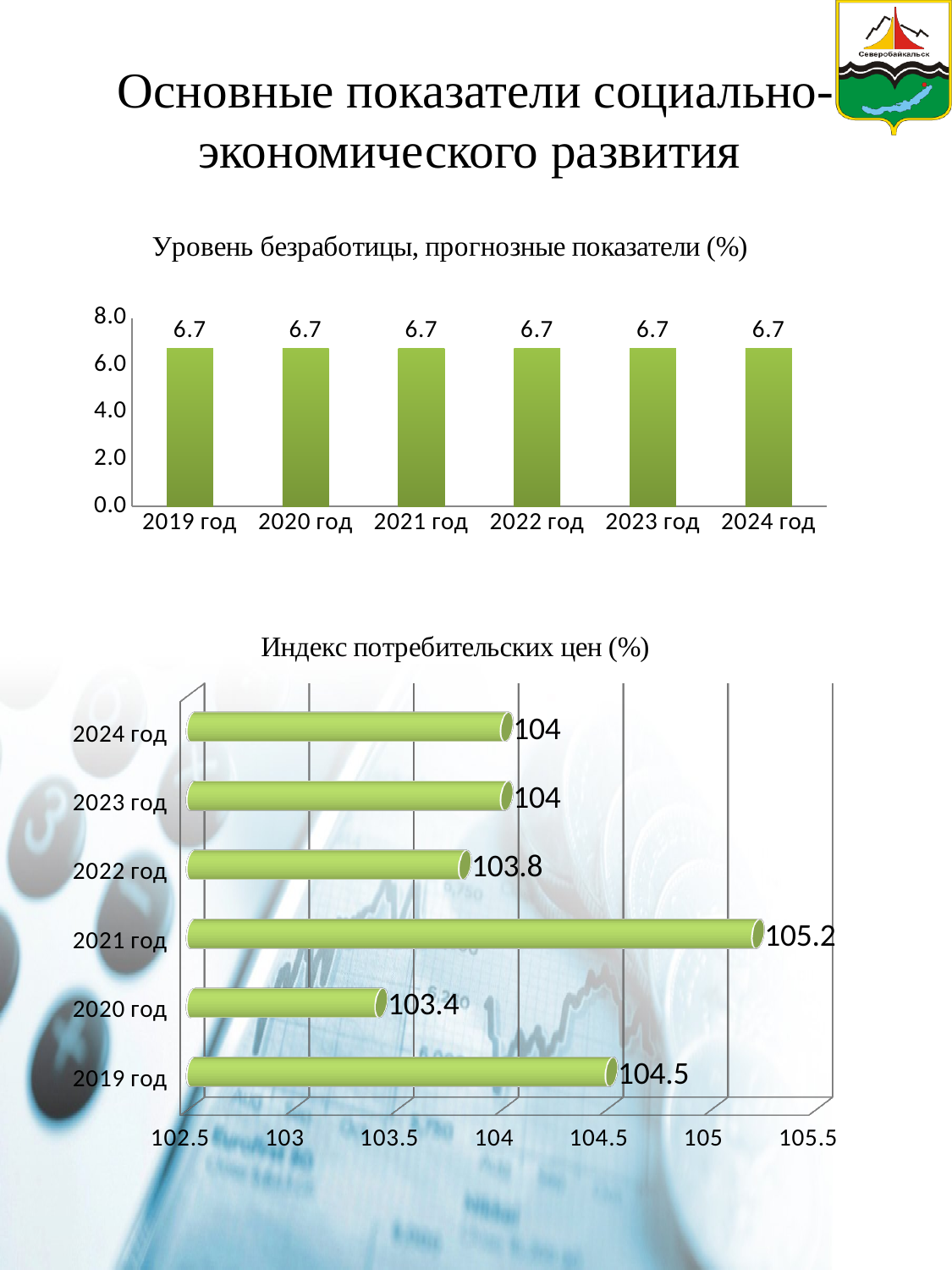
In the chart titled "Индекс потребительских цен (%)", what is the value for 2020 год? 103.4 In the chart titled "Индекс потребительских цен (%)", which is larger, the value for 2019 год or the value for 2022 год? 2019 год In the chart titled "Уровень безработицы, прогнозные показатели (%)", do the values rise, fall or stay the same from 2019 год to 2024 год? stay the same In the chart titled "Уровень безработицы, прогнозные показатели (%)", what is the value for 2021 год? 6.7 In the chart titled "Индекс потребительских цен (%)", what is the difference between the values for 2021 год and 2020 год? 1.8 In the chart titled "Индекс потребительских цен (%)", how many years are shown? 6 In the chart titled "Индекс потребительских цен (%)", which year has the lowest value? 2020 год What kind of chart is the one titled "Уровень безработицы, прогнозные показатели (%)"? bar chart In the chart titled "Индекс потребительских цен (%)", what is the value for 2021 год? 105.2 In the chart titled "Уровень безработицы, прогнозные показатели (%)", how many years are shown on the x axis? 6 In the chart titled "Индекс потребительских цен (%)", which year has the highest value? 2021 год What kind of chart is the one titled "Индекс потребительских цен (%)"? bar chart